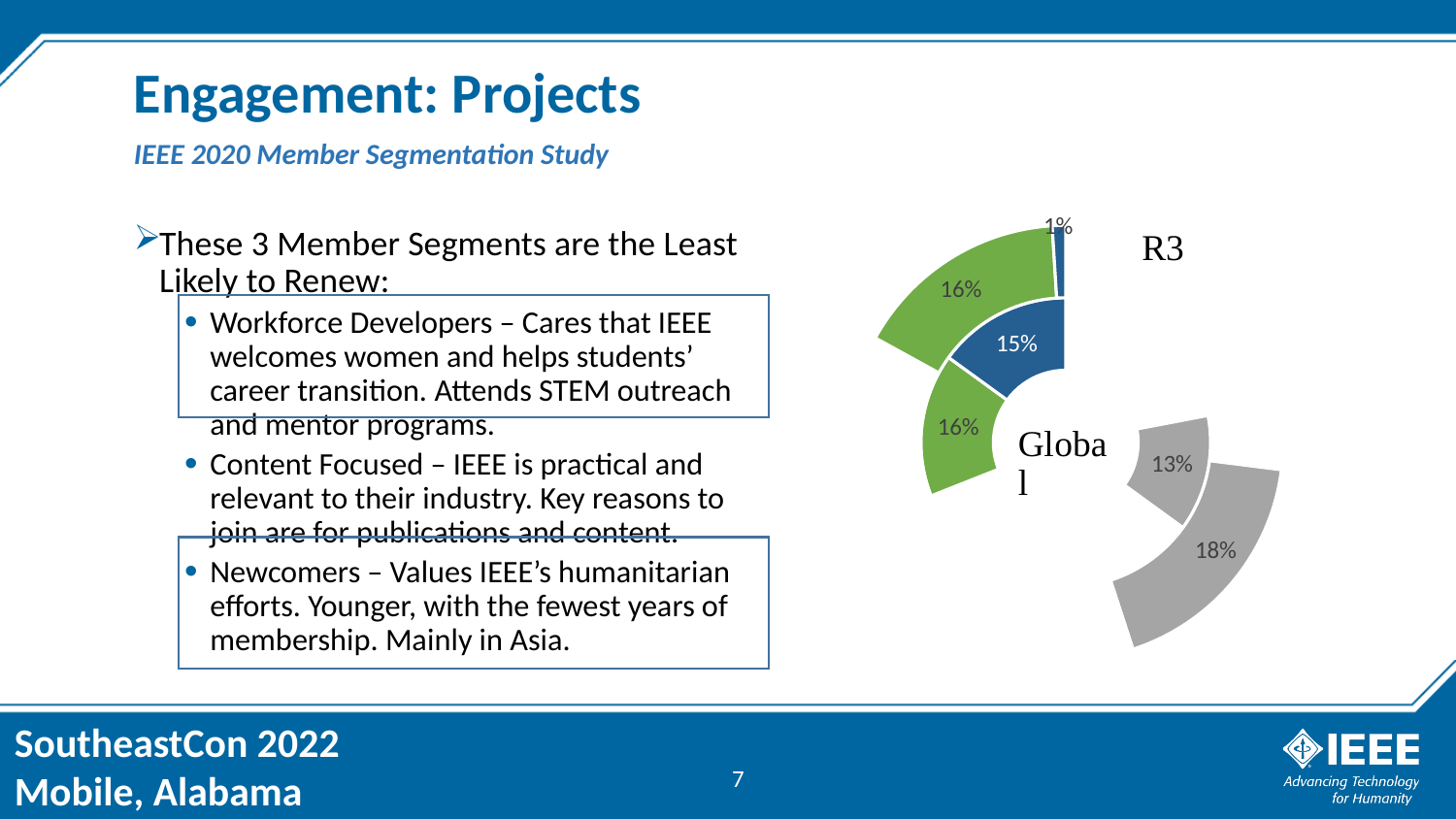
Which is larger on the pie chart, the slice labelled 15% or the slice labelled 13%? The slice labelled 15% How many slices of the pie chart are labelled 16%? 2 What is the difference between the largest and smallest percentages labelled on the pie chart? 17 percentage points What is the difference between the two gray slices labelled 18% and 13%? 5 percentage points What kind of chart is shown on the right side of the slide? Doughnut chart What is the smallest percentage labelled on the pie chart? 1% What colour are the two slices labelled 16%? Green What percentage is shown on the largest gray slice of the pie chart? 18% What percentage is shown on the blue slice in the middle of the pie chart? 15% What two text labels appear next to the pie chart? R3 and Global What is the largest percentage labelled on the pie chart? 18% How many slices are labelled with percentages in the pie chart? 6